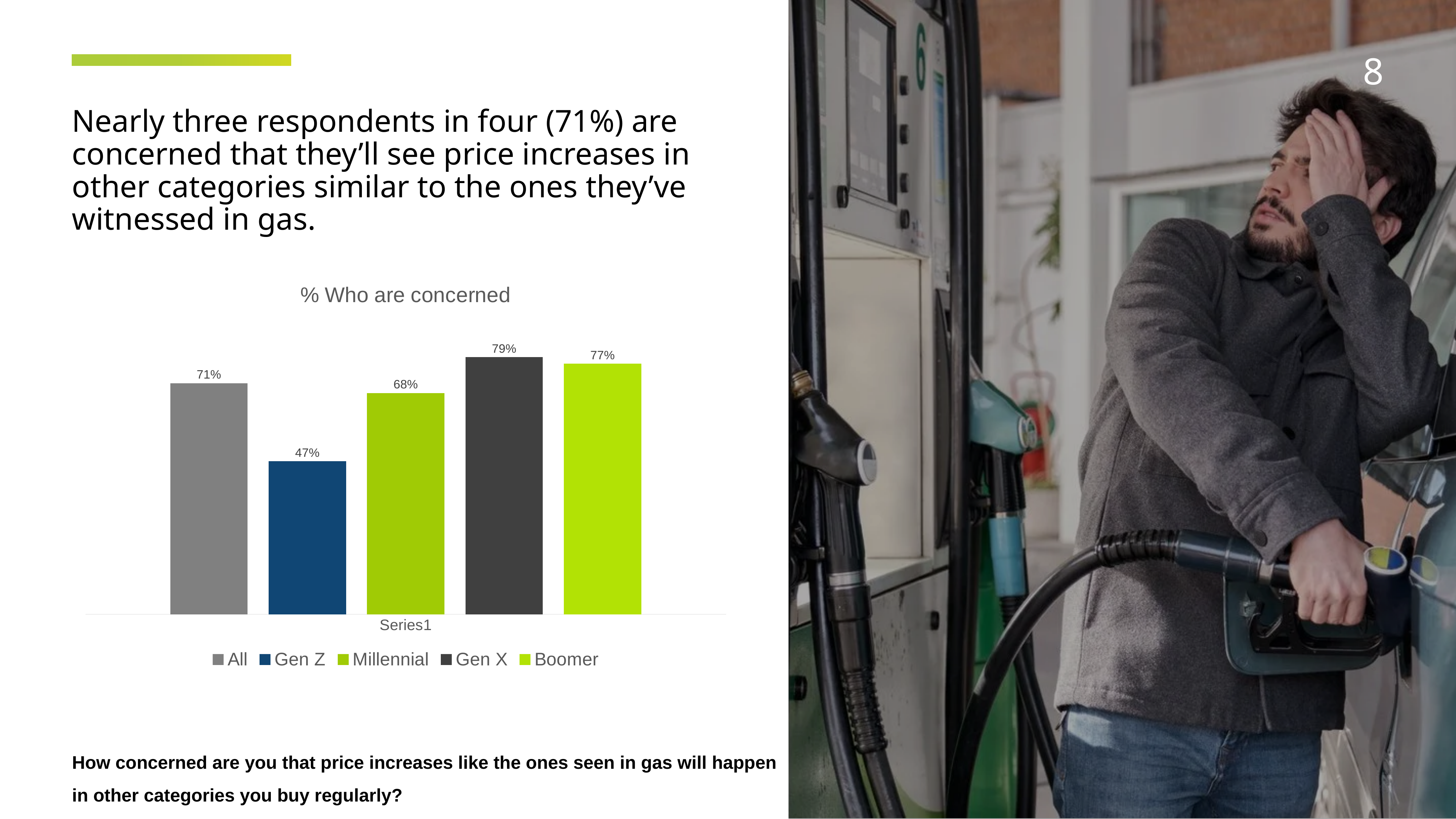
What is the value for Boomer in the chart? 77% What kind of chart is shown on the slide? Bar chart What is the difference between the Gen X value and the Gen Z value? 32% How many series does the legend list? 5 What colour is the Gen Z bar in the chart? Blue Which group has the highest percentage who are concerned? Gen X Which group has the lowest percentage who are concerned? Gen Z What is the title of the chart? % Who are concerned What is the value for Gen X in the chart? 79% What is the value for Millennial in the chart? 68% Which is larger, the value for Millennial or the value for Boomer? Boomer What is the value for Gen Z in the chart? 47%